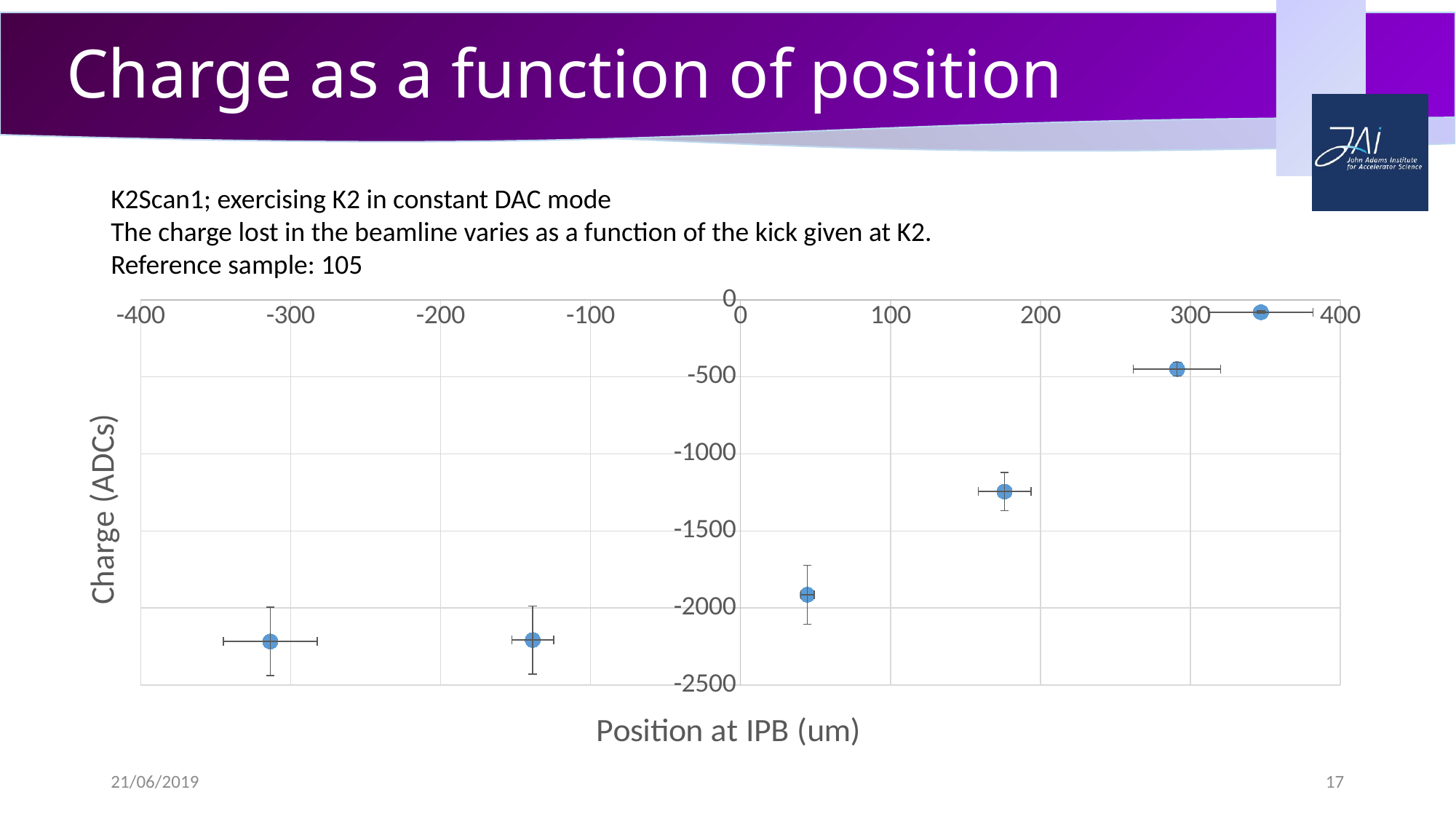
Is the charge for the data point near 50 um greater or less than -1500? less What is the lowest value shown on the vertical axis? -2500 Which data point has the highest charge: the one near -300 um or the one near 350 um? the one near 350 um What is the label of the horizontal axis? Position at IPB (um) How many data points are plotted on the chart? 6 Does the charge rise or fall as the position at IPB increases from left to right? rise Is the charge for the data point near 300 um greater or less than -1000? greater Which data point has a larger charge: the one near 175 um or the one near 300 um? the one near 300 um Is the charge for the data point near 175 um greater or less than -1000? less What kind of chart is shown on the slide? scatter chart What is the label of the vertical axis? Charge (ADCs)